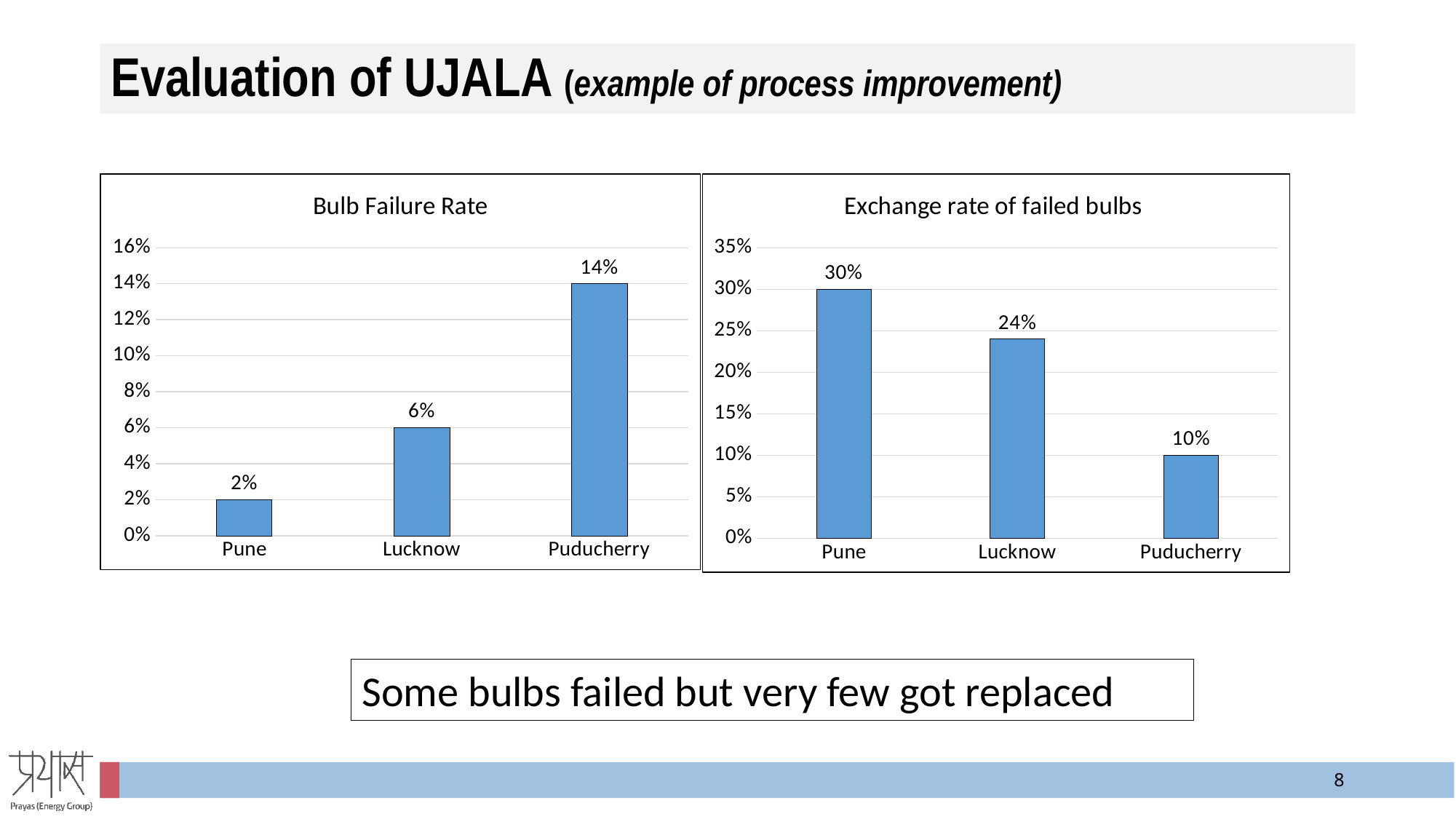
What is the title of the chart on the right side of the slide? Exchange rate of failed bulbs In the Exchange rate of failed bulbs chart, what is the difference between the values for Pune and Lucknow? 6% In the Bulb Failure Rate chart, which is larger, the value for Lucknow or the value for Pune? Lucknow In the Bulb Failure Rate chart, what is the value for Puducherry? 14% In the Bulb Failure Rate chart, which city has the highest bulb failure rate? Puducherry In the Bulb Failure Rate chart, do the values rise or fall from Pune to Puducherry? Rise In the Bulb Failure Rate chart, what is the difference between the values for Puducherry and Pune? 12% How many cities are shown in the Bulb Failure Rate chart? 3 In the Exchange rate of failed bulbs chart, what is the value for Lucknow? 24% What kind of chart is the Exchange rate of failed bulbs chart? Bar chart In the Exchange rate of failed bulbs chart, is the value for Pune greater or less than 25%? greater In the Exchange rate of failed bulbs chart, which city has the lowest exchange rate? Puducherry